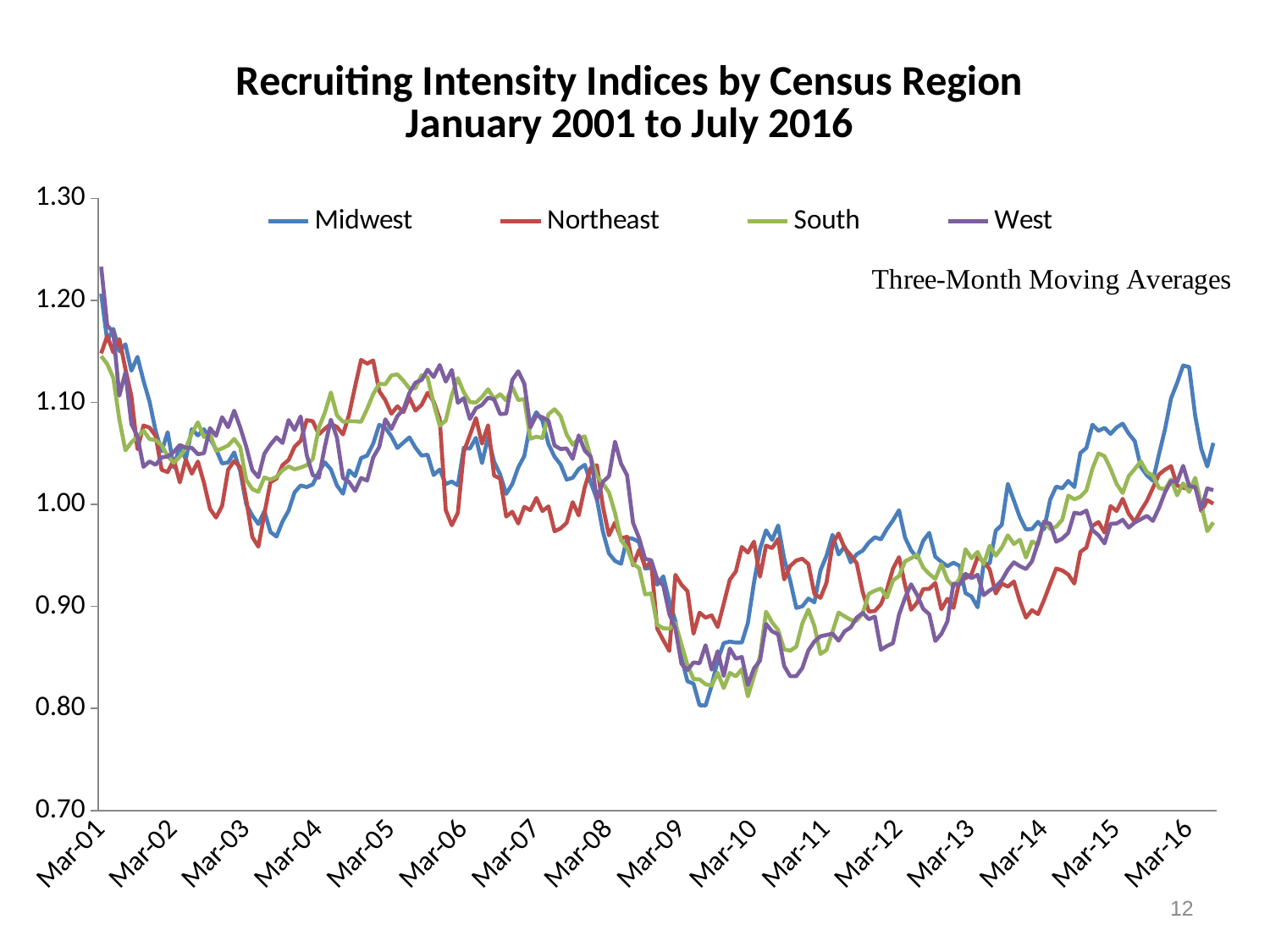
What note appears in the upper right of the plot area describing how the series are computed? Three-Month Moving Averages Around Mar-12, which is larger, the Midwest value or the West value? Midwest What is the title of the chart? Recruiting Intensity Indices by Census Region January 2001 to July 2016 What kind of chart is shown on the slide? Line chart Is the value of the South series around Mar-10 greater or less than 0.90? less Is the lowest value of the Midwest series, reached around late 2009, greater or less than 0.90? less How many series does the legend list? 4 How many year labels (Mar-01 through Mar-16) are shown on the x axis? 16 Is the peak of the Midwest series around early 2016 greater or less than 1.10? greater Between Mar-08 and Mar-09, do the series generally rise or fall? fall Which series reaches the highest value around Mar-16? Midwest